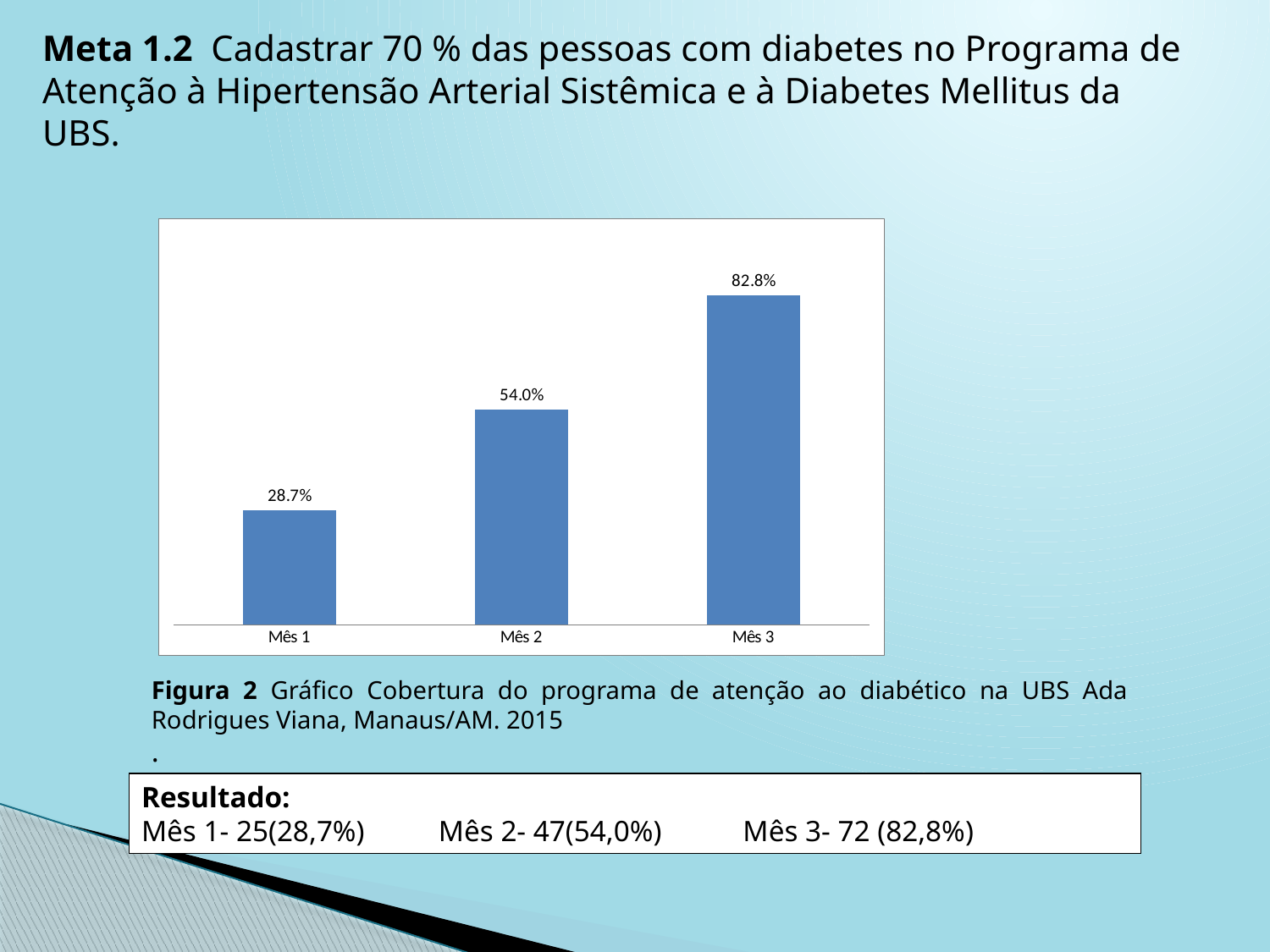
Which is larger, the value for Mês 2 or the value for Mês 3? Mês 3 What is the difference between the values for Mês 3 and Mês 1? 54.1% Which month has the lowest value? Mês 1 Do the values rise or fall from Mês 1 to Mês 3? Rise What is the difference between the values for Mês 2 and Mês 1? 25.3% What kind of chart is shown on the slide? Bar chart How many categories are shown on the x axis? 3 What is the value for Mês 1? 28.7% Which month has the highest value? Mês 3 What is the value for Mês 2? 54.0% What is the value for Mês 3? 82.8% What is the difference between the values for Mês 3 and Mês 2? 28.8%